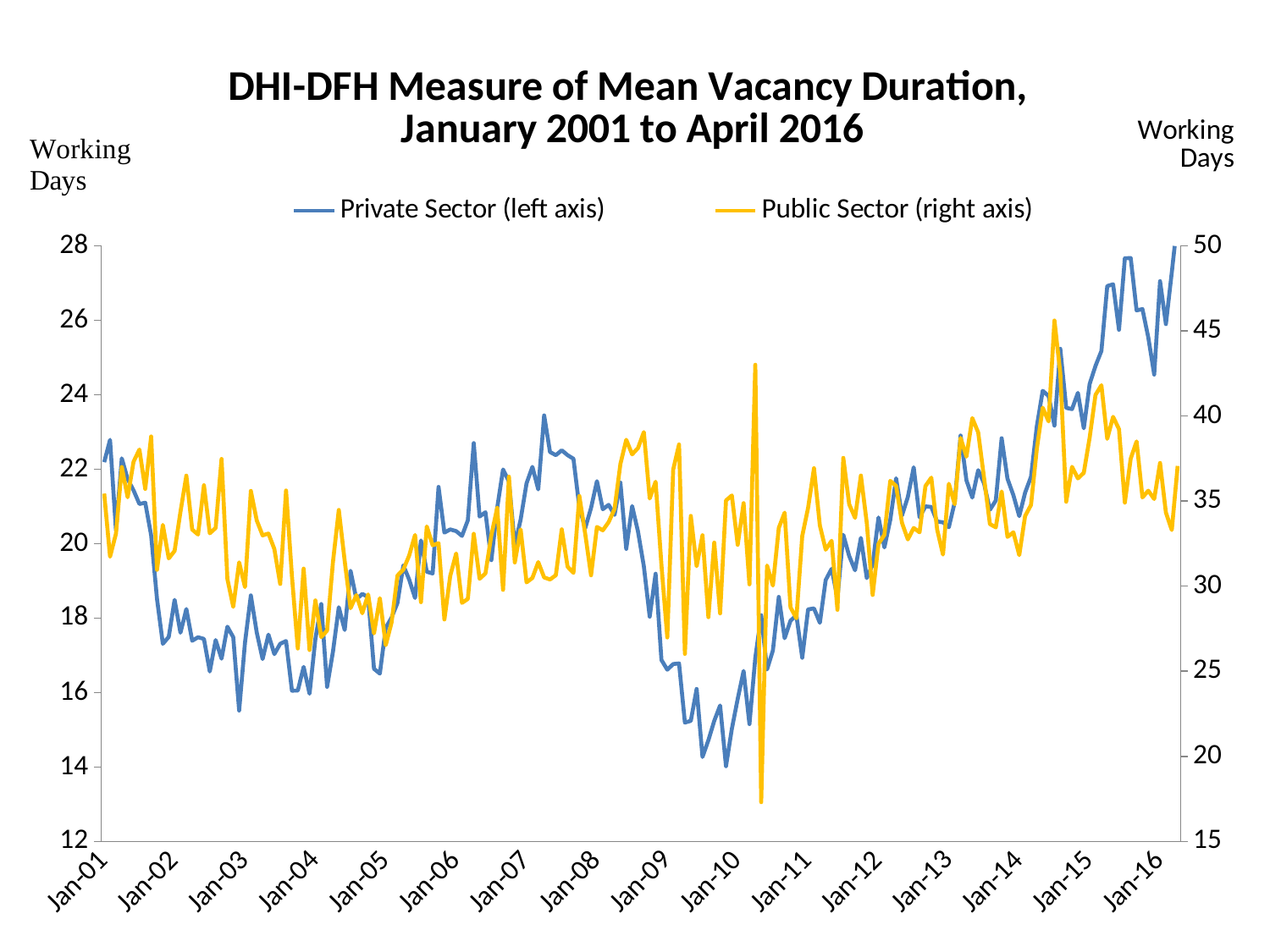
Is the Private Sector value around Jan-08 greater or less than 20? greater Is the lowest Public Sector value (the dip in 2010) greater or less than 20 on the right axis? less Does the Private Sector series rise or fall between Jan-08 and Jan-10? fall Does the Private Sector series rise or fall between Jan-14 and Jan-16? rise What kind of chart is shown on the slide? line chart Is the Private Sector value around Jan-16 greater or less than 26? greater What is the title of the chart? DHI-DFH Measure of Mean Vacancy Duration, January 2001 to April 2016 How many series does the legend list? 2 Which series is plotted against the right axis? Public Sector